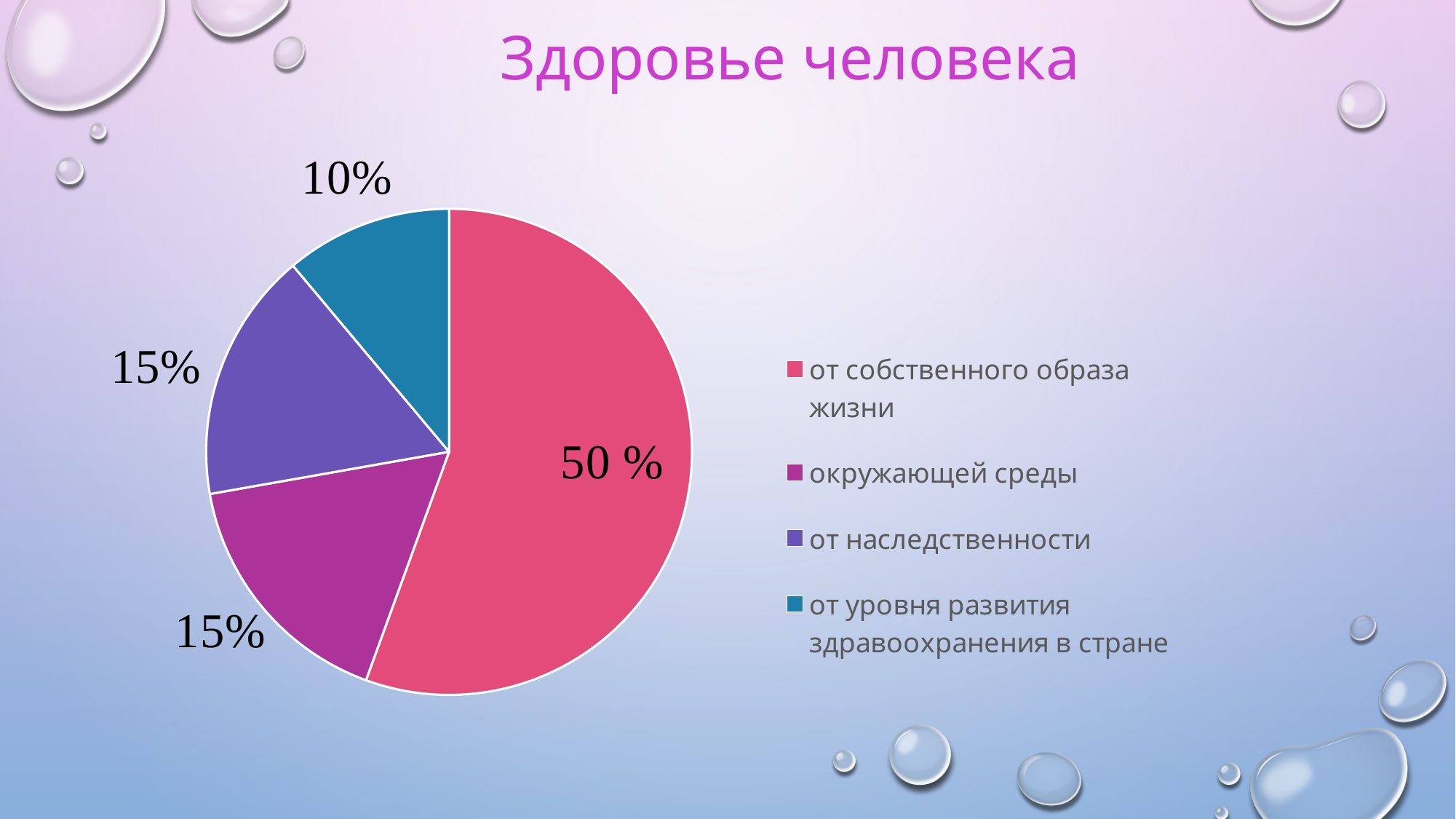
Which is larger: the value for "окружающей среды" or the value for "от уровня развития здравоохранения в стране"? окружающей среды What is the value for "от уровня развития здравоохранения в стране"? 10% What is the title of the slide containing the pie chart? Здоровье человека What kind of chart is shown on the slide? pie chart What is the value for "окружающей среды"? 15% Which category has the smallest slice of the pie? от уровня развития здравоохранения в стране What share of the pie does "от собственного образа жизни" take? 50 % How many slices does the pie chart have? 4 What is the value for "от собственного образа жизни"? 50 % Which category has the largest slice of the pie? от собственного образа жизни What is the difference between the value for "от собственного образа жизни" and the value for "от наследственности"? 35% What is the value for "от наследственности"? 15%